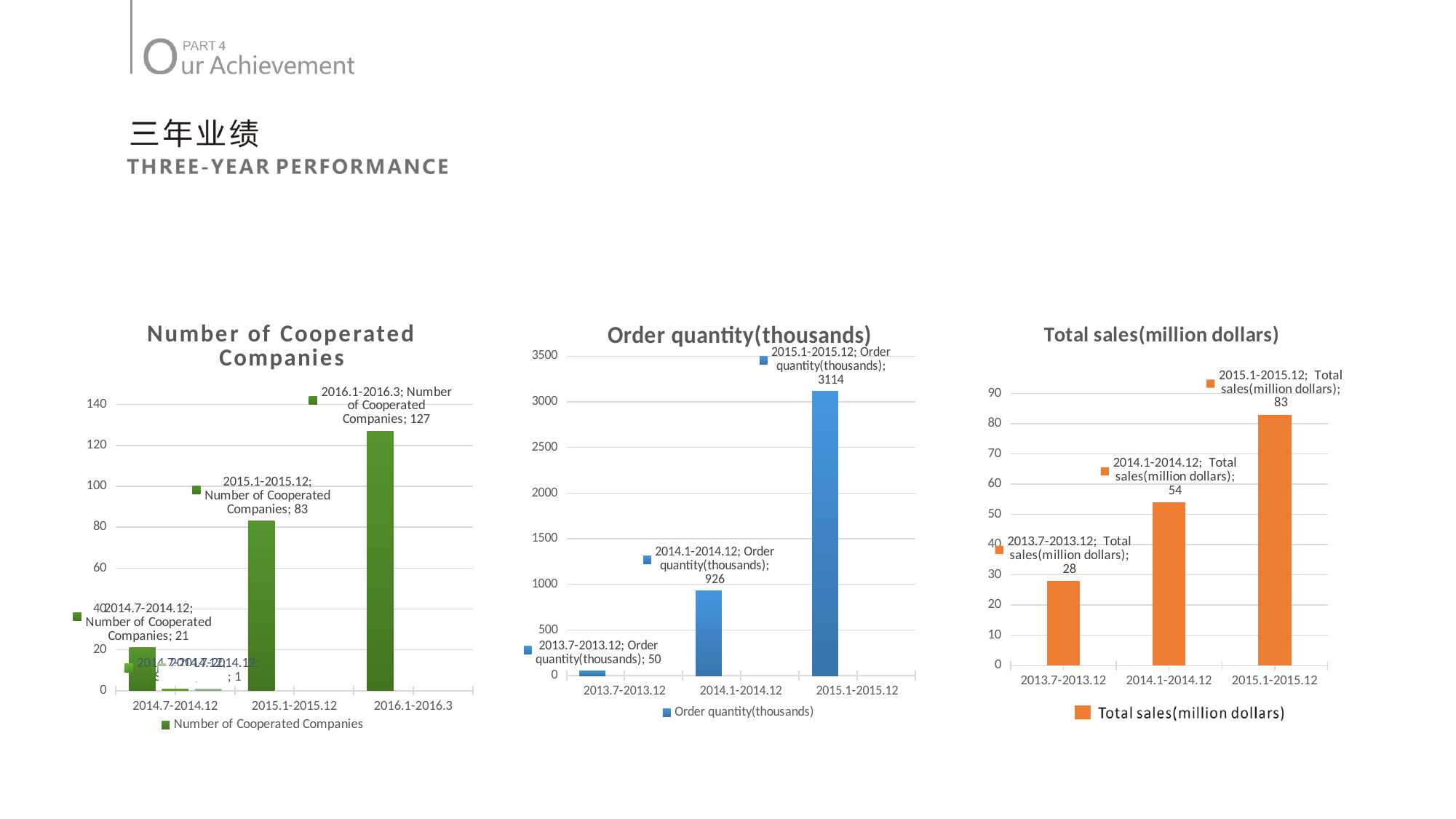
In the 'Order quantity(thousands)' chart, what is the value for 2015.1-2015.12? 3114 In the 'Total sales(million dollars)' chart, which period has the highest value? 2015.1-2015.12 What kind of chart is the 'Order quantity(thousands)' chart? bar chart In the 'Total sales(million dollars)' chart, what is the difference between the values for 2015.1-2015.12 and 2013.7-2013.12? 55 In the 'Order quantity(thousands)' chart, what is the value for 2013.7-2013.12? 50 In the 'Number of Cooperated Companies' chart, what is the value for 2016.1-2016.3? 127 In the 'Total sales(million dollars)' chart, do the values rise or fall from left to right along the x axis? rise How many periods are shown on the x axis of the 'Total sales(million dollars)' chart? 3 In the 'Order quantity(thousands)' chart, which period has the lowest value? 2013.7-2013.12 In the 'Total sales(million dollars)' chart, what is the value for 2014.1-2014.12? 54 In the 'Number of Cooperated Companies' chart, which is larger: the value for 2015.1-2015.12 or the value for 2016.1-2016.3? 2016.1-2016.3 In the 'Order quantity(thousands)' chart, what is the difference between the values for 2015.1-2015.12 and 2014.1-2014.12? 2188